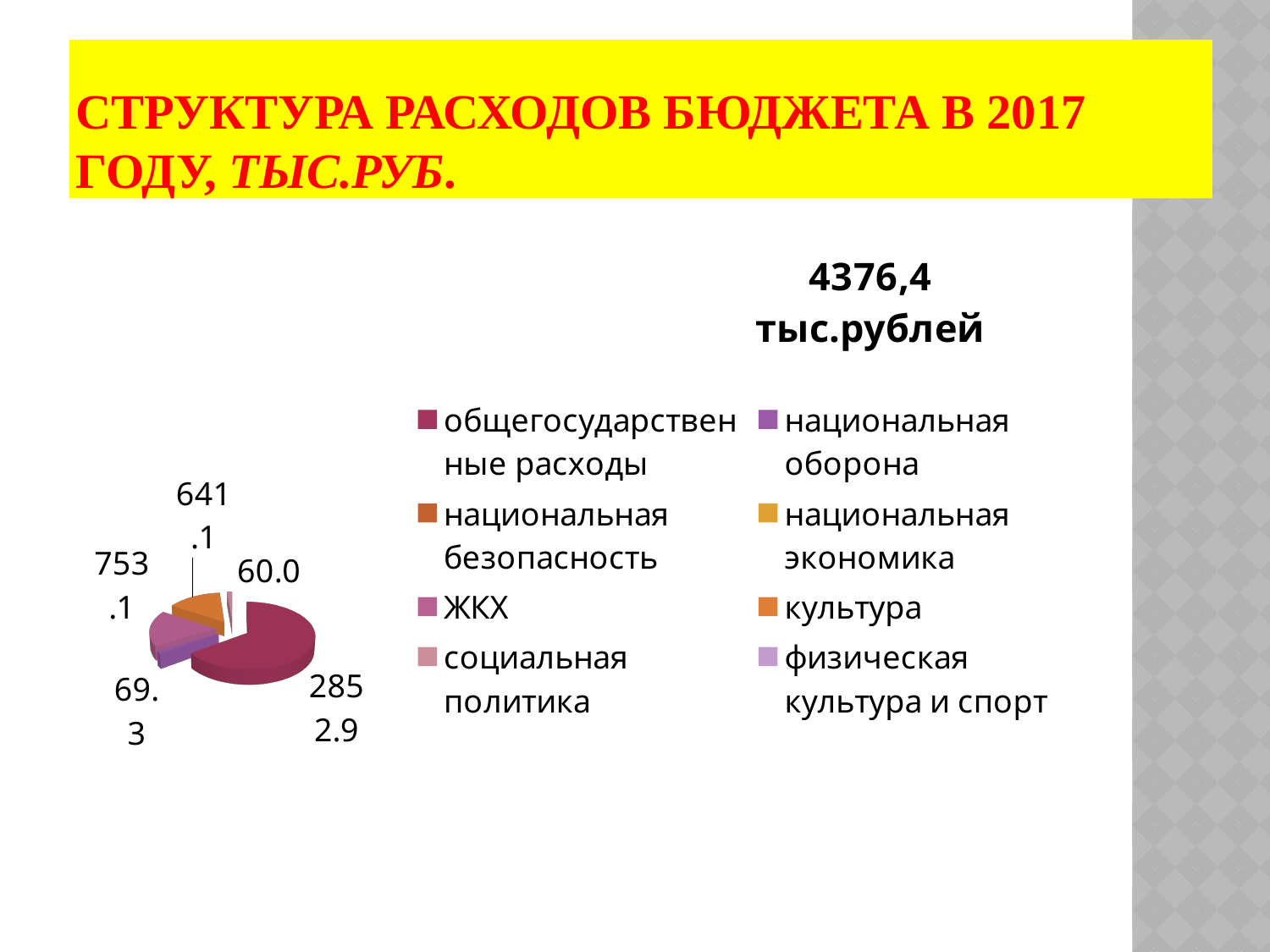
What value is labelled on the largest slice of the pie chart (общегосударственные расходы)? 2852.9 What total amount of budget expenditure is printed above the legend? 4376,4 тыс.рублей How many categories does the legend of the pie chart list? 8 What is the difference between the data labels 753.1 and 641.1 on the pie chart? 112.0 How many data labels are printed around the pie chart? 5 Is the value of the largest slice of the pie chart greater or less than 2000? greater What kind of chart is shown on the slide? pie chart Which is larger among the pie chart's data labels: 753.1 or 641.1? 753.1 What is the title of the slide containing the pie chart? СТРУКТУРА РАСХОДОВ БЮДЖЕТА В 2017 ГОДУ, ТЫС.РУБ. Which category has the largest slice in the pie chart? общегосударственные расходы What is the smallest value printed as a data label on the pie chart? 60.0